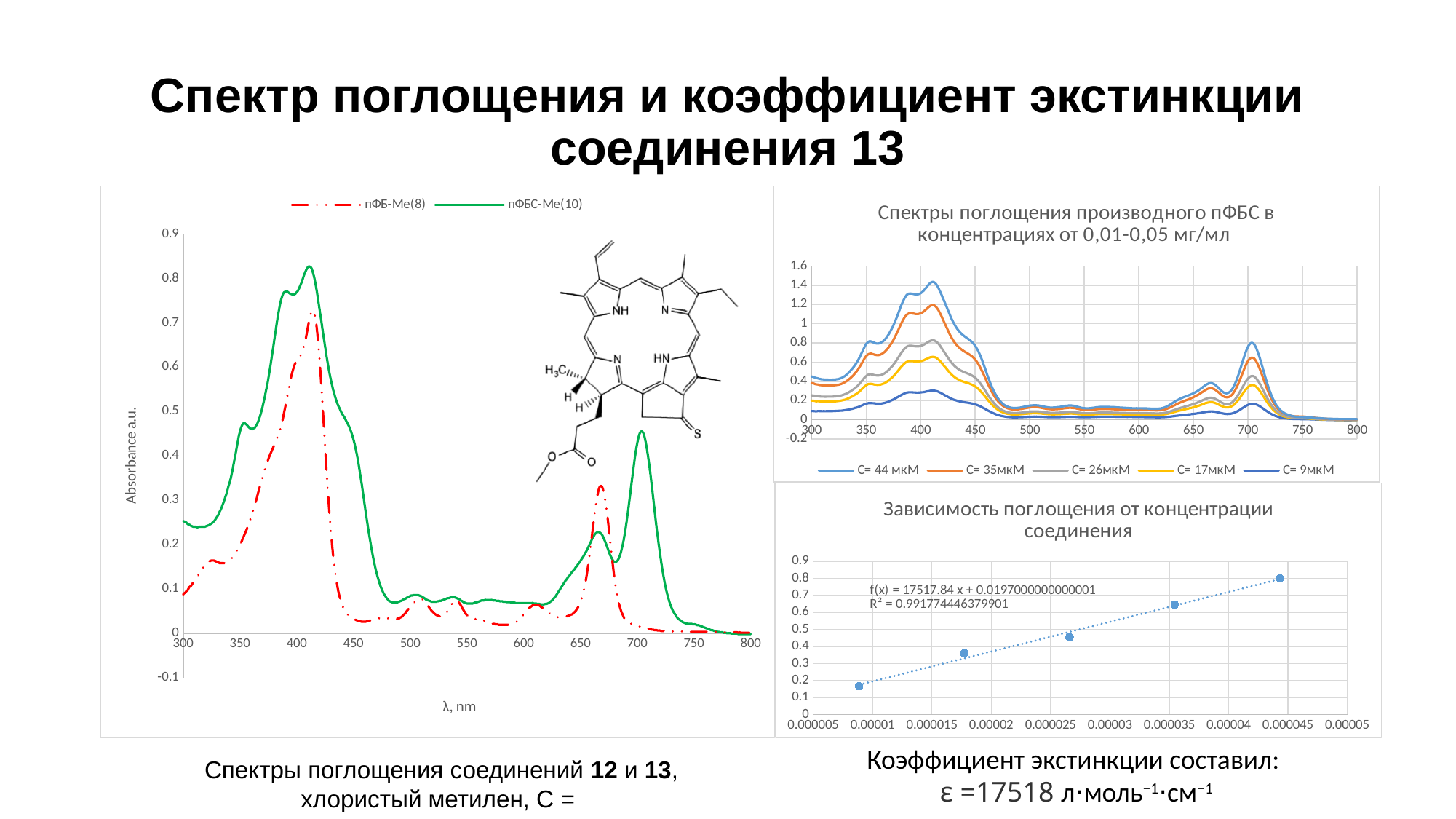
In the top-right chart of absorption spectra at different concentrations, which series has the highest absorbance peak? C= 44 мкМ In the bottom-right chart 'Зависимость поглощения от концентрации соединения', is the value of the rightmost point greater or less than 0.7? greater In the bottom-right chart 'Зависимость поглощения от концентрации соединения', do the values rise or fall as concentration increases along the x axis? rise In the top-right chart of absorption spectra at different concentrations, is the peak value of the C= 44 мкМ series near 410 nm greater or less than 1.2? greater In the left chart with the y axis 'Absorbance a.u.', how many series does the legend list? 2 In the top-right chart titled 'Спектры поглощения производного пФБС в концентрациях от 0,01-0,05 мг/мл', how many series does the legend list? 5 In the left chart with the y axis 'Absorbance a.u.', which series has the higher absorbance at 700 nm, пФБ-Me(8) or пФБС-Me(10)? пФБС-Me(10) In the bottom-right chart 'Зависимость поглощения от концентрации соединения', what is the trendline equation shown on the chart? f(x) = 17517.84 x + 0.0197000000000001 What kind of chart is the left chart with the y axis 'Absorbance a.u.'? line chart In the bottom-right chart titled 'Зависимость поглощения от концентрации соединения', how many data points are plotted? 5 In the top-right chart of absorption spectra at different concentrations, which series has the lowest absorbance values? C= 9мкМ In the top-right chart of absorption spectra at different concentrations, is the peak value of the C= 9мкМ series near 410 nm greater or less than 0.4? less